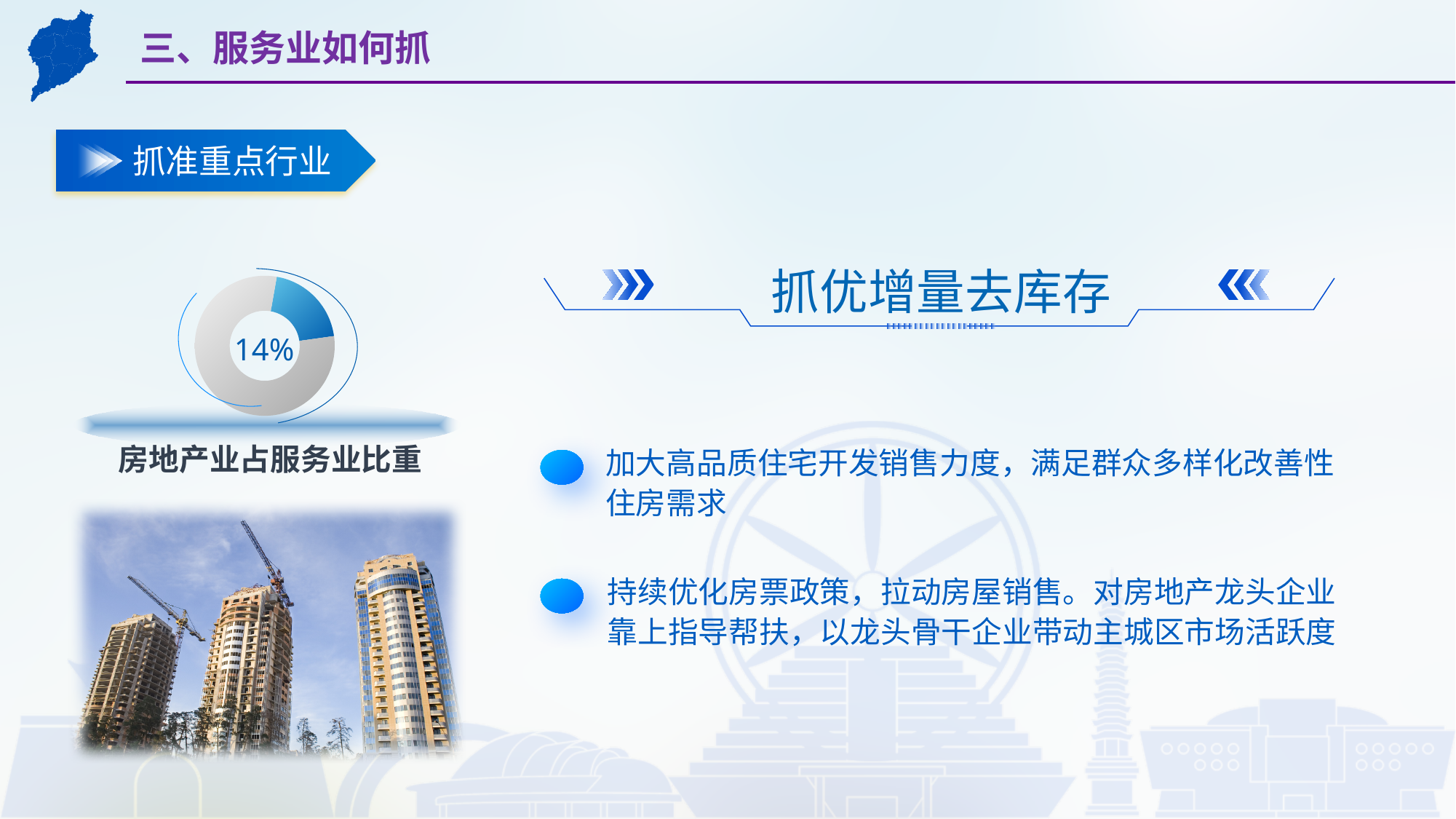
According to the chart, what share of the service industry does the real estate industry (房地产业) account for? 14% What is the caption printed below the donut chart? 房地产业占服务业比重 What percentage is printed in the centre of the donut chart? 14% What colour is the slice representing the 14% share in the donut chart? Blue How many slices does the donut chart have? 2 What kind of chart is shown on the left of the slide? Donut (pie) chart Which slice of the donut chart is larger, the blue slice or the grey slice? The grey slice